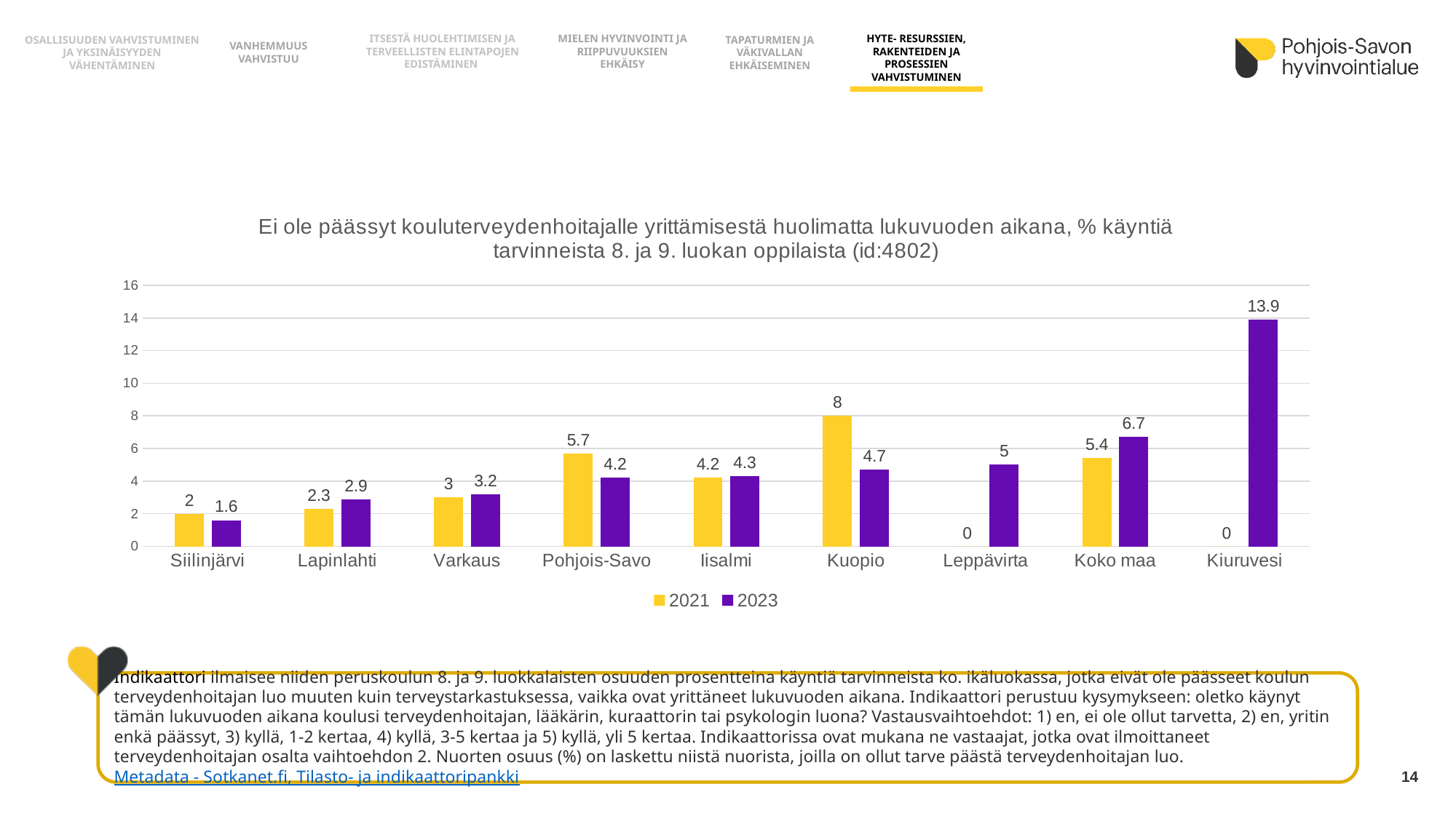
Which series is shown in yellow? 2021 What is the 2023 value for Koko maa? 6.7 How many categories are shown on the x axis? 9 What is the 2023 value for Kiuruvesi? 13.9 What is the 2021 value for Kuopio? 8 What is the difference between the 2023 and 2021 values for Koko maa? 1.3 Which category has the highest 2023 value? Kiuruvesi Which category has the lowest 2023 value? Siilinjärvi What is the 2021 value for Pohjois-Savo? 5.7 What kind of chart is shown on the slide? bar chart Which is larger for Kuopio, the 2021 value or the 2023 value? 2021 How many series does the legend list? 2